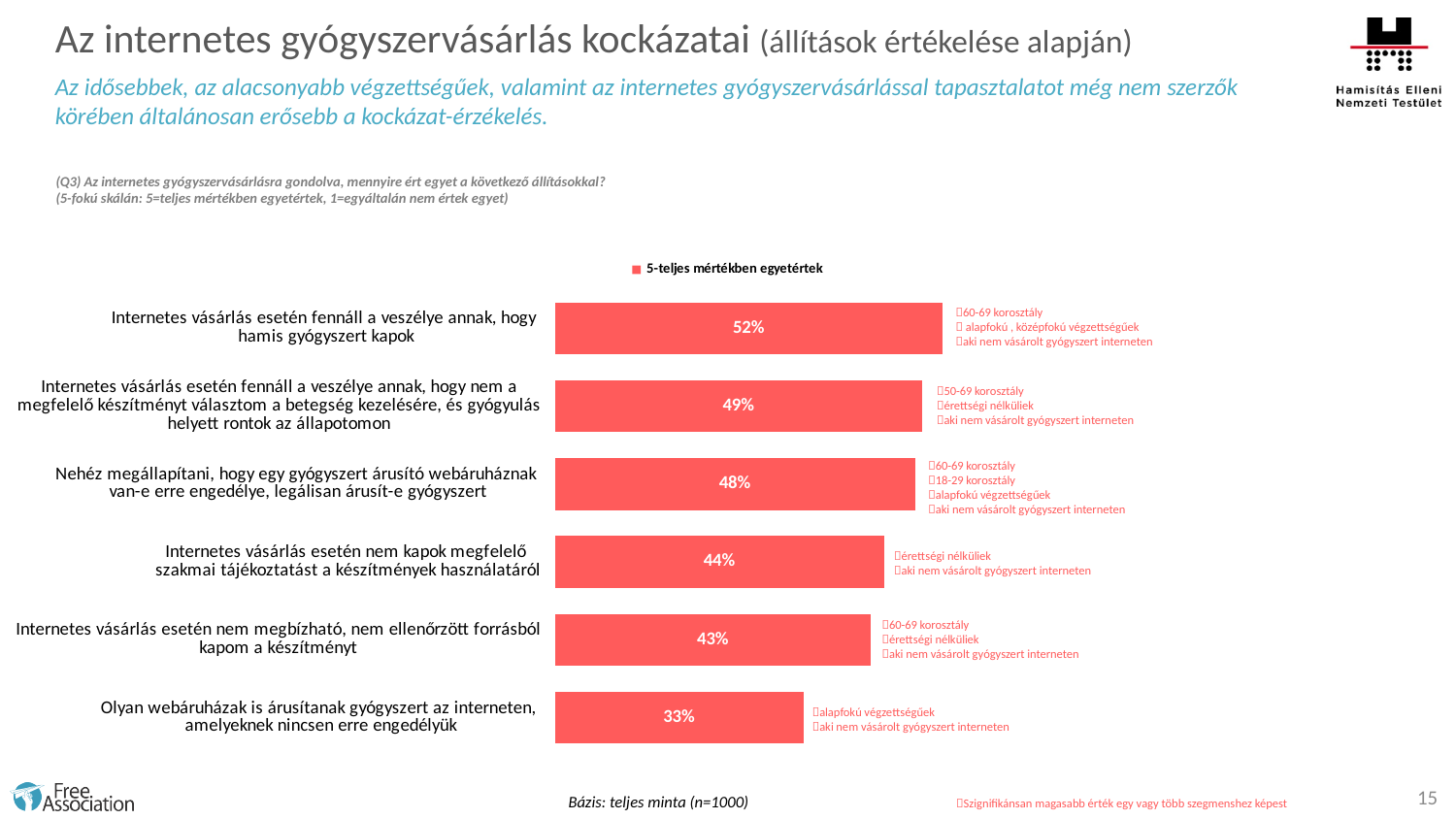
What is the value for the statement "Internetes vásárlás esetén nem kapok megfelelő szakmai tájékoztatást a készítmények használatáról"? 44% What type of chart is shown on the slide? Bar chart Which is larger: the value for "Internetes vásárlás esetén fennáll a veszélye annak, hogy nem a megfelelő készítményt választom..." or the value for "Internetes vásárlás esetén nem kapok megfelelő szakmai tájékoztatást..."? Internetes vásárlás esetén fennáll a veszélye annak, hogy nem a megfelelő készítményt választom... What is the name of the series shown in the chart legend? 5-teljes mértékben egyetértek Which statement has the lowest share of respondents fully agreeing? Olyan webáruházak is árusítanak gyógyszert az interneten, amelyeknek nincsen erre engedélyük What percentage fully agree that buying online carries the risk of receiving counterfeit medicine ("Internetes vásárlás esetén fennáll a veszélye annak, hogy hamis gyógyszert kapok")? 52% How many statements (bars) are shown in the chart? 6 What is the value for the statement "Olyan webáruházak is árusítanak gyógyszert az interneten, amelyeknek nincsen erre engedélyük"? 33% Which statement has the highest share of respondents fully agreeing? Internetes vásárlás esetén fennáll a veszélye annak, hogy hamis gyógyszert kapok How many series does the chart legend list? 1 What is the difference between the value for "Nehéz megállapítani, hogy egy gyógyszert árusító webáruháznak van-e erre engedélye..." and the value for "Internetes vásárlás esetén nem megbízható, nem ellenőrzött forrásból kapom a készítményt"? 5 percentage points What is the difference in percentage points between the highest bar (52%) and the lowest bar (33%)? 19 percentage points